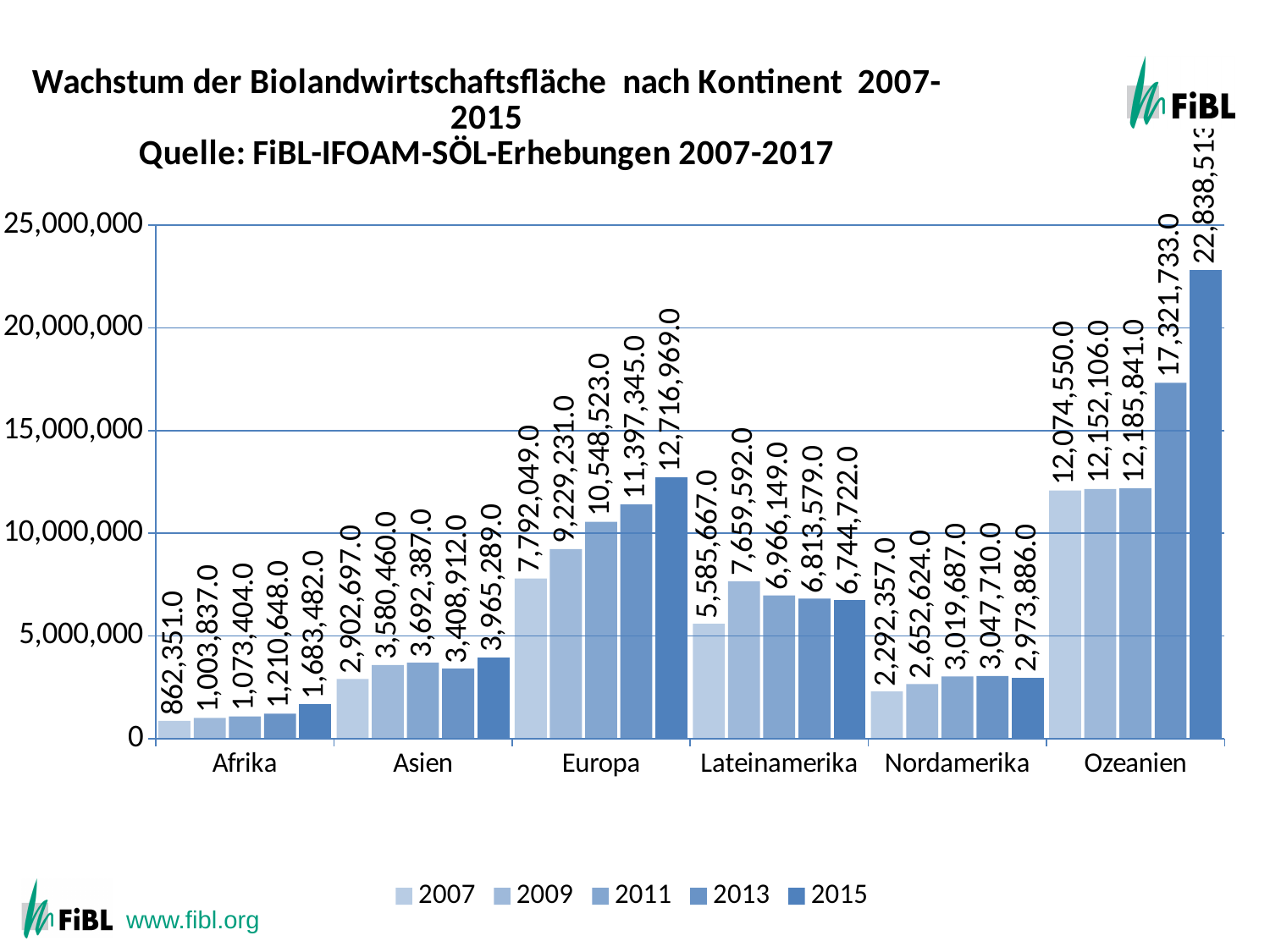
What is the value for Europa in 2015? 12,716,969.0 By how much did the value for Europa increase from 2007 to 2015? 4,924,920.0 Is the value for Ozeanien in 2015 greater or less than 20,000,000? greater Which continent has the lowest value in 2007? Afrika What kind of chart is shown on the slide? bar chart How many series does the legend list? 5 Do the values for Europa rise or fall from 2007 to 2015? rise Which is larger in 2015: the value for Asien or the value for Nordamerika? Asien Which continent has the highest value in 2015? Ozeanien How many continents are shown on the x axis? 6 What is the value for Afrika in 2007? 862,351.0 What is the value for Lateinamerika in 2009? 7,659,592.0